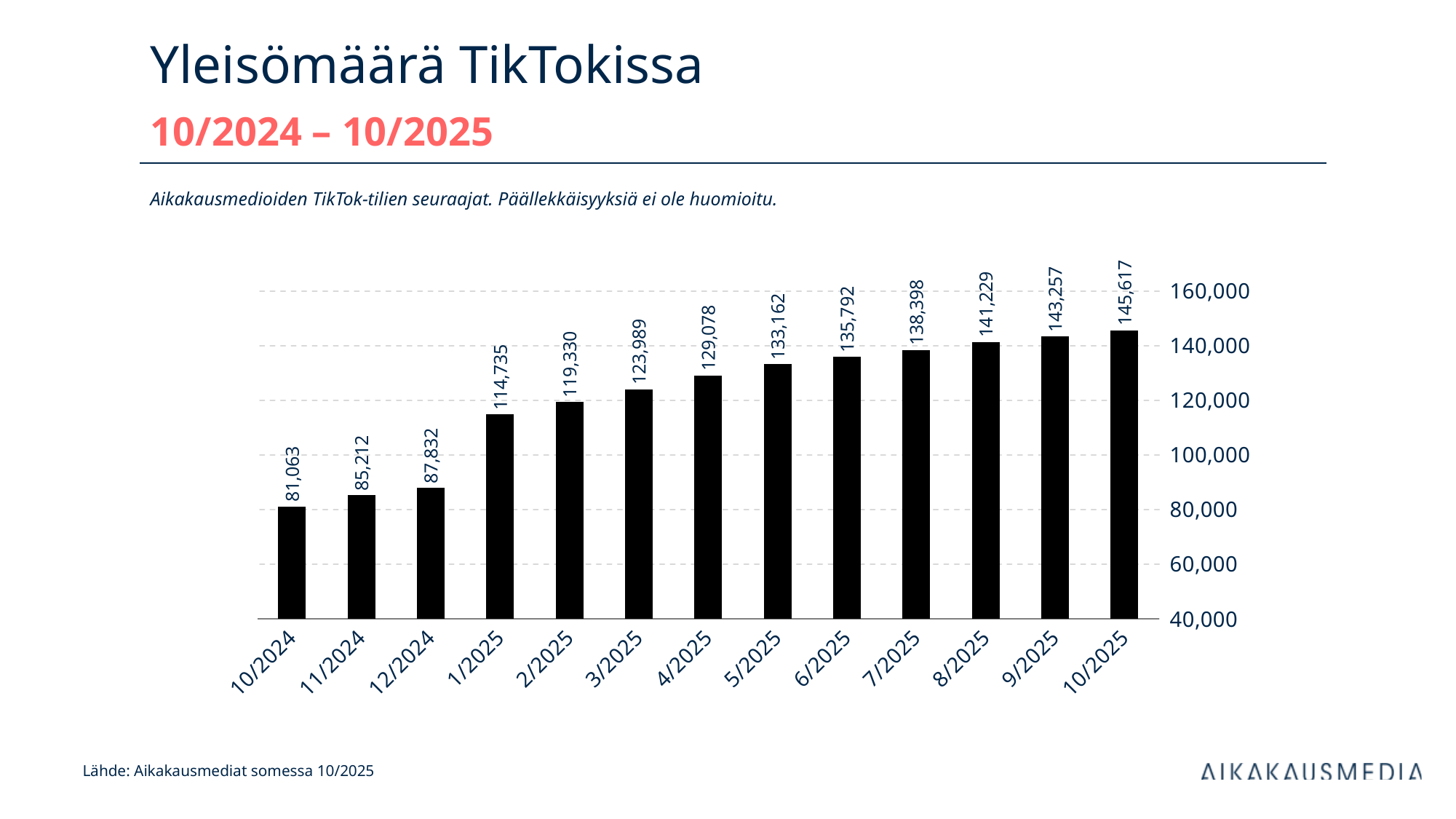
What kind of chart is shown on the slide? bar chart Is the value for 6/2025 greater or less than 140,000? less What is the value for 10/2024? 81,063 What is the value for 1/2025? 114,735 What is the value for 10/2025? 145,617 Which month has the lowest value? 10/2024 Which month has the highest value? 10/2025 What is the difference between the values for 10/2025 and 10/2024? 64,554 Which is larger, the value for 5/2025 or the value for 3/2025? 5/2025 How many months are shown on the x axis? 13 What is the difference between the values for 1/2025 and 12/2024? 26,903 Do the values rise or fall from 10/2024 to 10/2025? rise